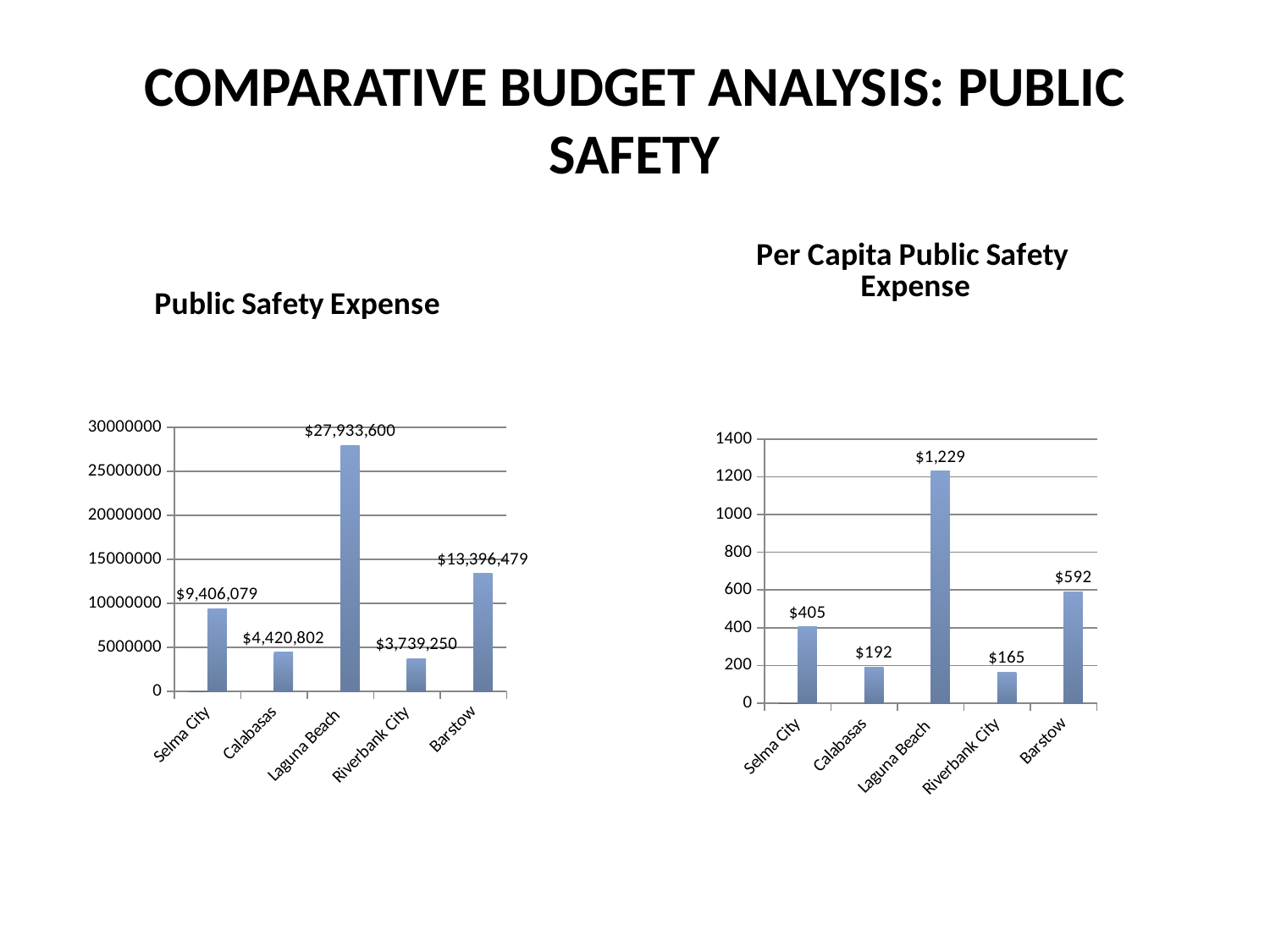
In the Per Capita Public Safety Expense chart, which is larger, Calabasas or Riverbank City? Calabasas In the Per Capita Public Safety Expense chart, which city has the highest value? Laguna Beach What kind of chart is the Per Capita Public Safety Expense chart? Bar chart In the Per Capita Public Safety Expense chart, what is the difference between Laguna Beach and Barstow? $637 In the Public Safety Expense chart, what is the difference between Barstow and Selma City? $3,990,400 In the Per Capita Public Safety Expense chart, what is the value for Barstow? $592 In the Public Safety Expense chart, is the value for Barstow greater or less than 10000000? greater In the Public Safety Expense chart, what is the value for Laguna Beach? $27,933,600 In the Public Safety Expense chart, what is the value for Riverbank City? $3,739,250 In the Public Safety Expense chart, which city has the lowest expense? Riverbank City In the Public Safety Expense chart, how many cities are shown? 5 In the Per Capita Public Safety Expense chart, what is the value for Selma City? $405